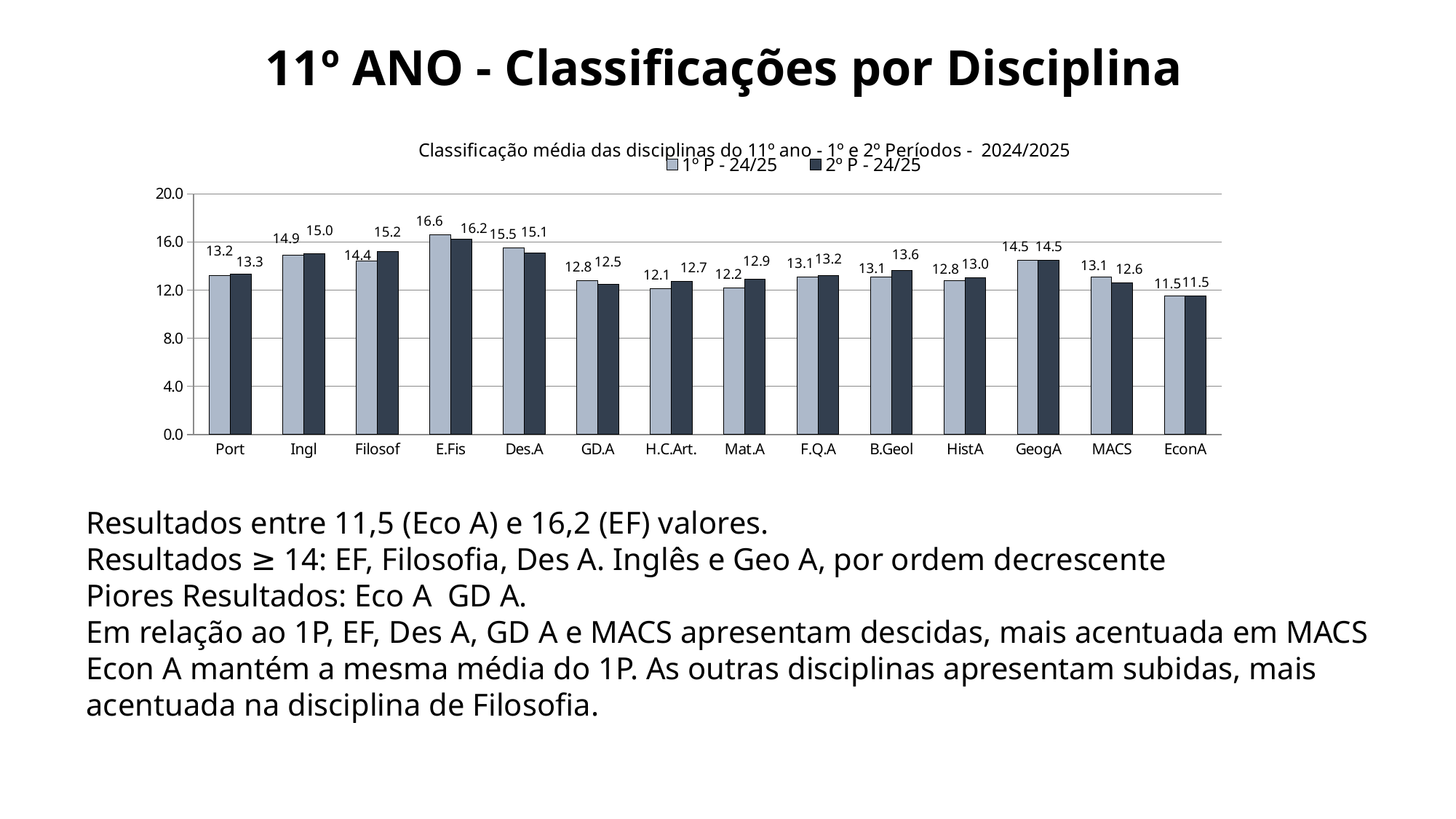
What is the value for E.Fis in the 1º P - 24/25 series? 16.6 Which discipline has the highest value in the 2º P - 24/25 series? E.Fis Which discipline has the lowest value in the 1º P - 24/25 series? EconA What is the value for Filosof in the 2º P - 24/25 series? 15.2 What is the difference between the 1º P - 24/25 and 2º P - 24/25 values for MACS? 0.5 What kind of chart is shown on the slide? Bar chart How many series does the legend list? 2 How many disciplines are shown on the x axis? 14 What is the value for MACS in the 2º P - 24/25 series? 12.6 What is the difference between the 2º P - 24/25 and 1º P - 24/25 values for Filosof? 0.8 Is the 2º P - 24/25 value for Ingl greater or less than 12.0? greater Which is larger for GD.A: the 1º P - 24/25 value or the 2º P - 24/25 value? 1º P - 24/25